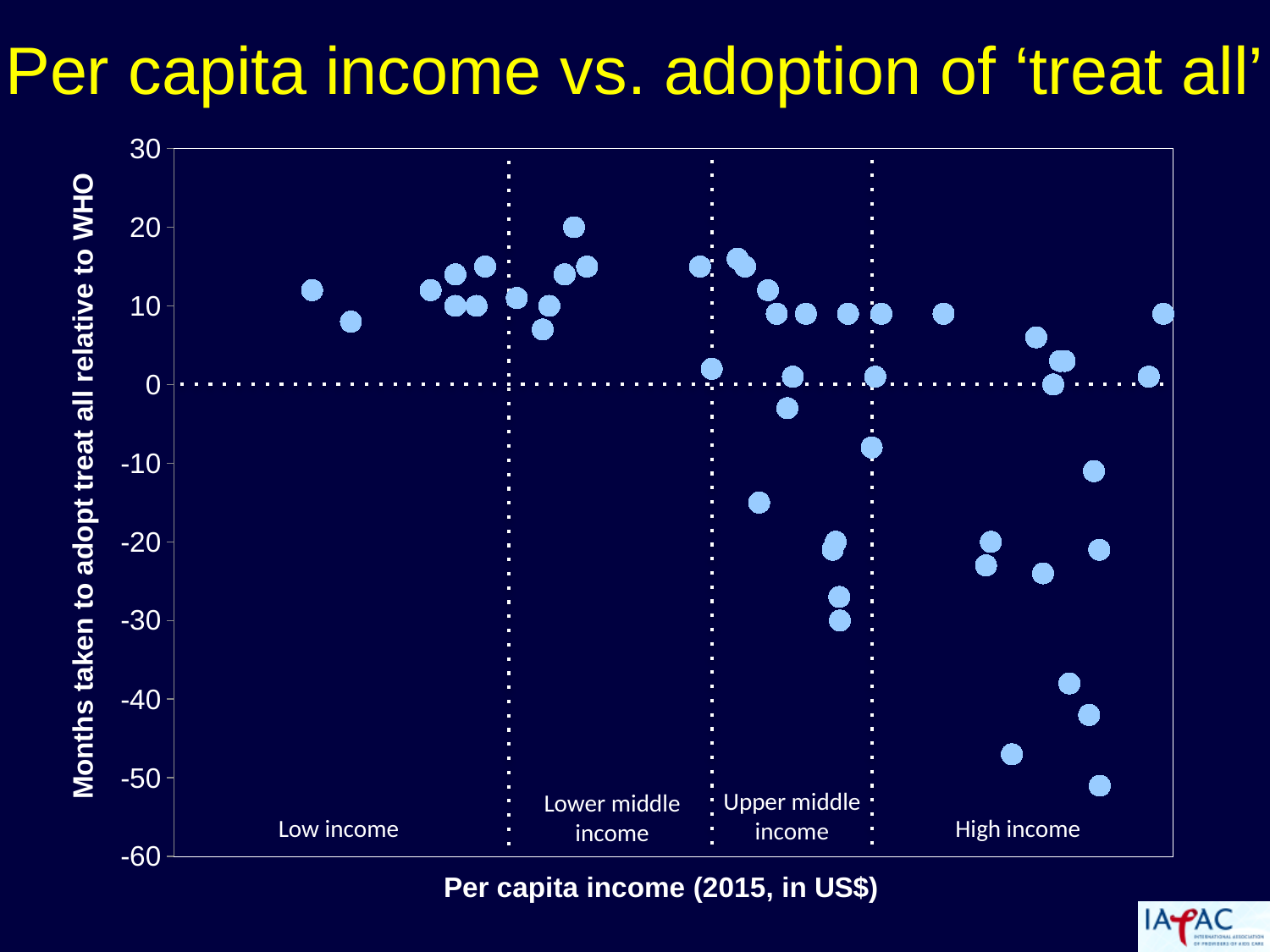
Is the lowest point in the High income group greater or less than -40? less Moving from the Low income group to the High income group, do the lowest points in each group rise or fall? fall Which group has a lower minimum point, Low income or High income? High income Is the lowest point in the Upper middle income group greater or less than -20? less What kind of chart is shown on the slide? Scatter chart What is the label of the vertical axis? Months taken to adopt treat all relative to WHO Is the highest point in the Lower middle income group greater or less than 10? greater What is the title of the chart? Per capita income vs. adoption of 'treat all' Which income group contains the highest point on the chart? Lower middle income How many income groups are marked along the horizontal axis? 4 Which income group contains the lowest point on the chart? High income